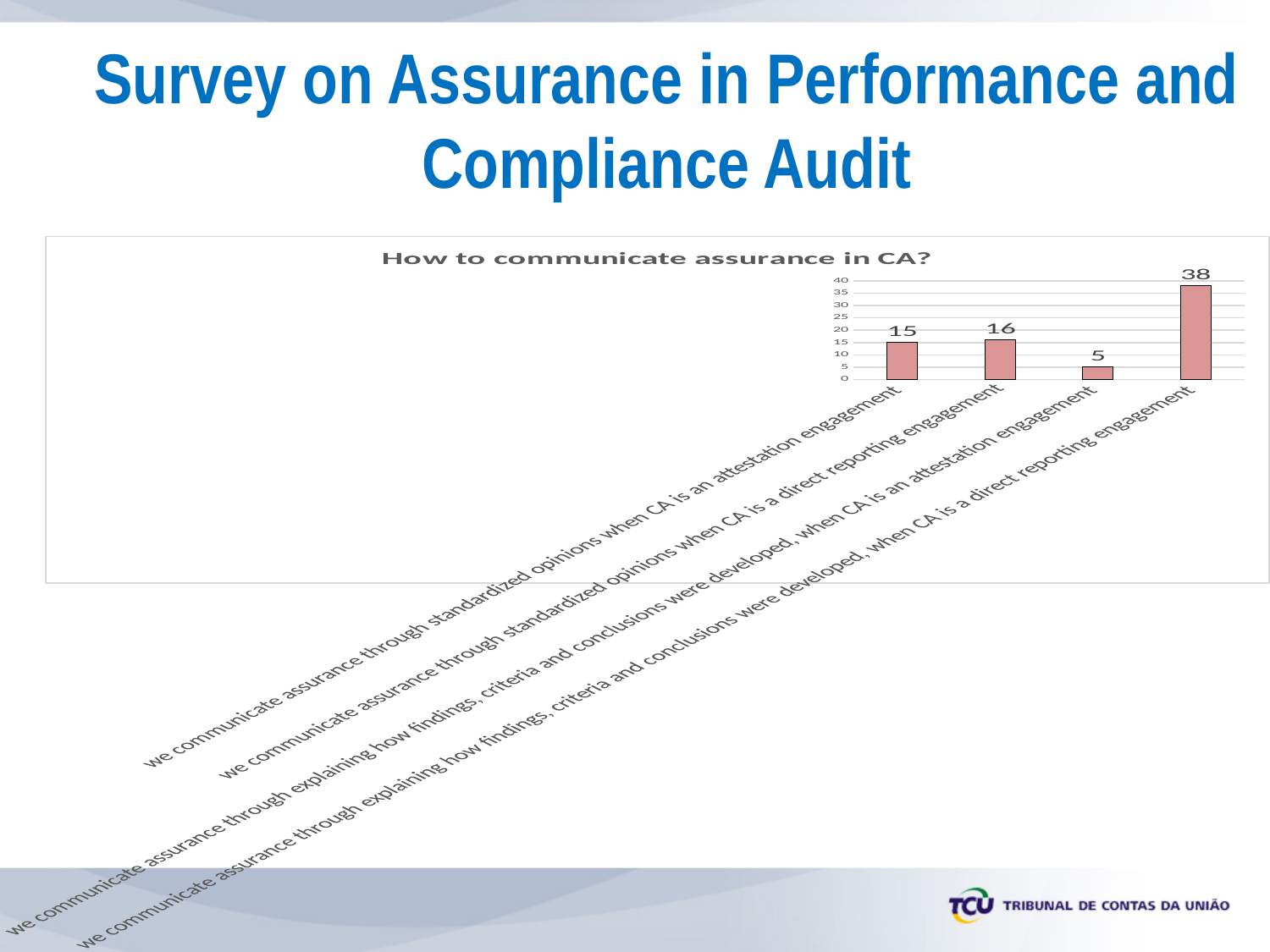
What is the value for 'we communicate assurance through explaining how findings, criteria and conclusions were developed, when CA is an attestation engagement'? 5 What is the value for 'we communicate assurance through standardized opinions when CA is an attestation engagement'? 15 Is the value for 'we communicate assurance through explaining how findings, criteria and conclusions were developed, when CA is a direct reporting engagement' greater or less than 30? greater What is the value for 'we communicate assurance through explaining how findings, criteria and conclusions were developed, when CA is a direct reporting engagement'? 38 What type of chart is shown on the slide? bar chart How many categories (bars) does the chart show? 4 What is the title of the chart? How to communicate assurance in CA? What is the difference between the highest value (38) and the lowest value (5)? 33 Which category has the highest value? we communicate assurance through explaining how findings, criteria and conclusions were developed, when CA is a direct reporting engagement Which category has the lowest value? we communicate assurance through explaining how findings, criteria and conclusions were developed, when CA is an attestation engagement What is the value for 'we communicate assurance through standardized opinions when CA is a direct reporting engagement'? 16 Which is larger: the value for standardized opinions when CA is an attestation engagement, or the value for explaining how findings, criteria and conclusions were developed when CA is an attestation engagement? standardized opinions when CA is an attestation engagement